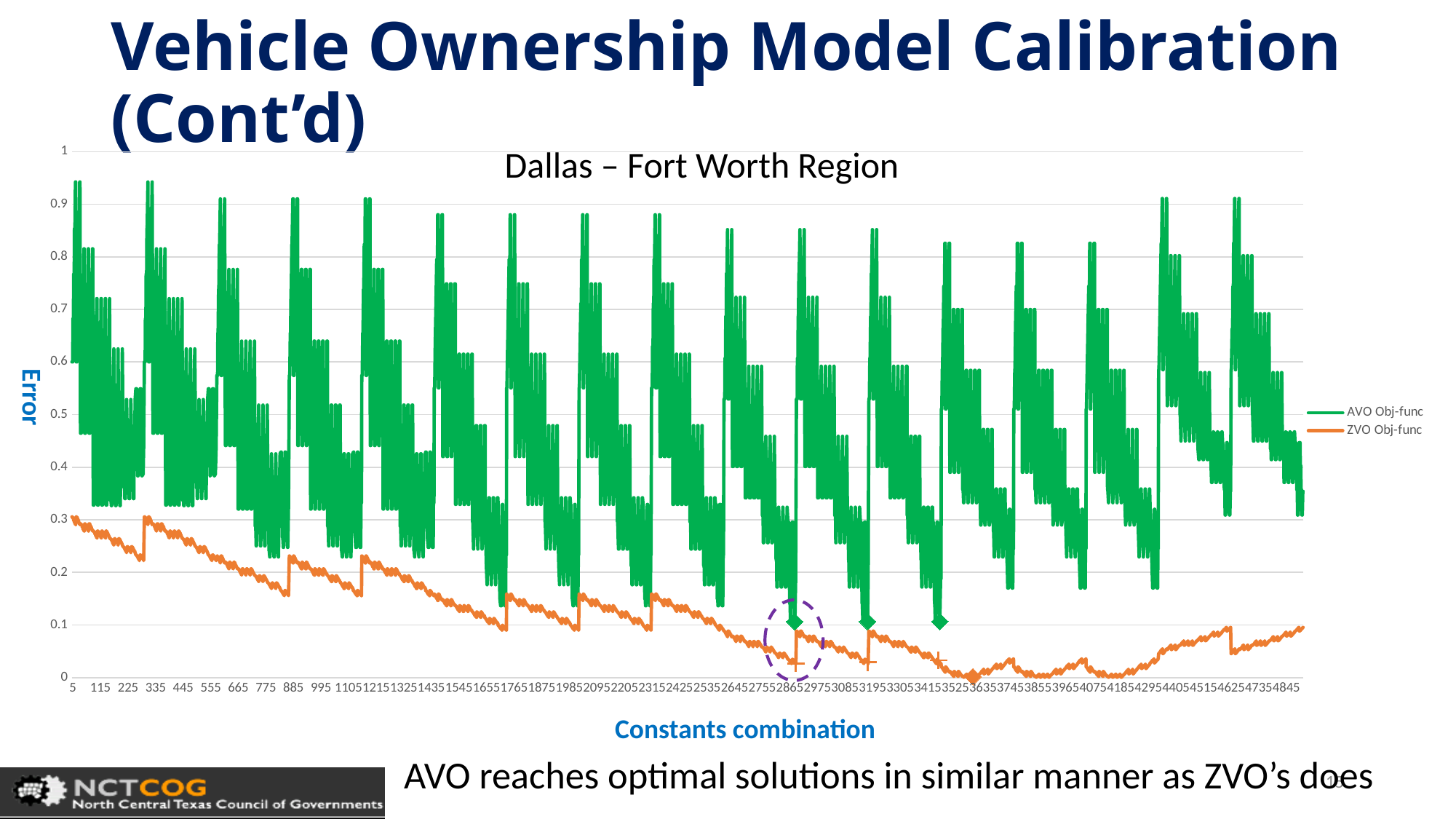
Is the highest value reached by the ZVO Obj-func series greater or less than 0.4? less Which series has the higher values overall, AVO Obj-func or ZVO Obj-func? AVO Obj-func Is the value of the ZVO Obj-func series at the first x-axis point (5) greater or less than 0.2? greater What is the title of the chart? Dallas – Fort Worth Region Is the value of the ZVO Obj-func series at the last x-axis point (4845) greater or less than 0.2? less Which series is drawn in orange according to the legend? ZVO Obj-func What kind of chart is shown on the slide? line chart Which series reaches the highest value on the chart? AVO Obj-func How many series does the legend list? 2 Which series reaches the lowest value on the chart? ZVO Obj-func